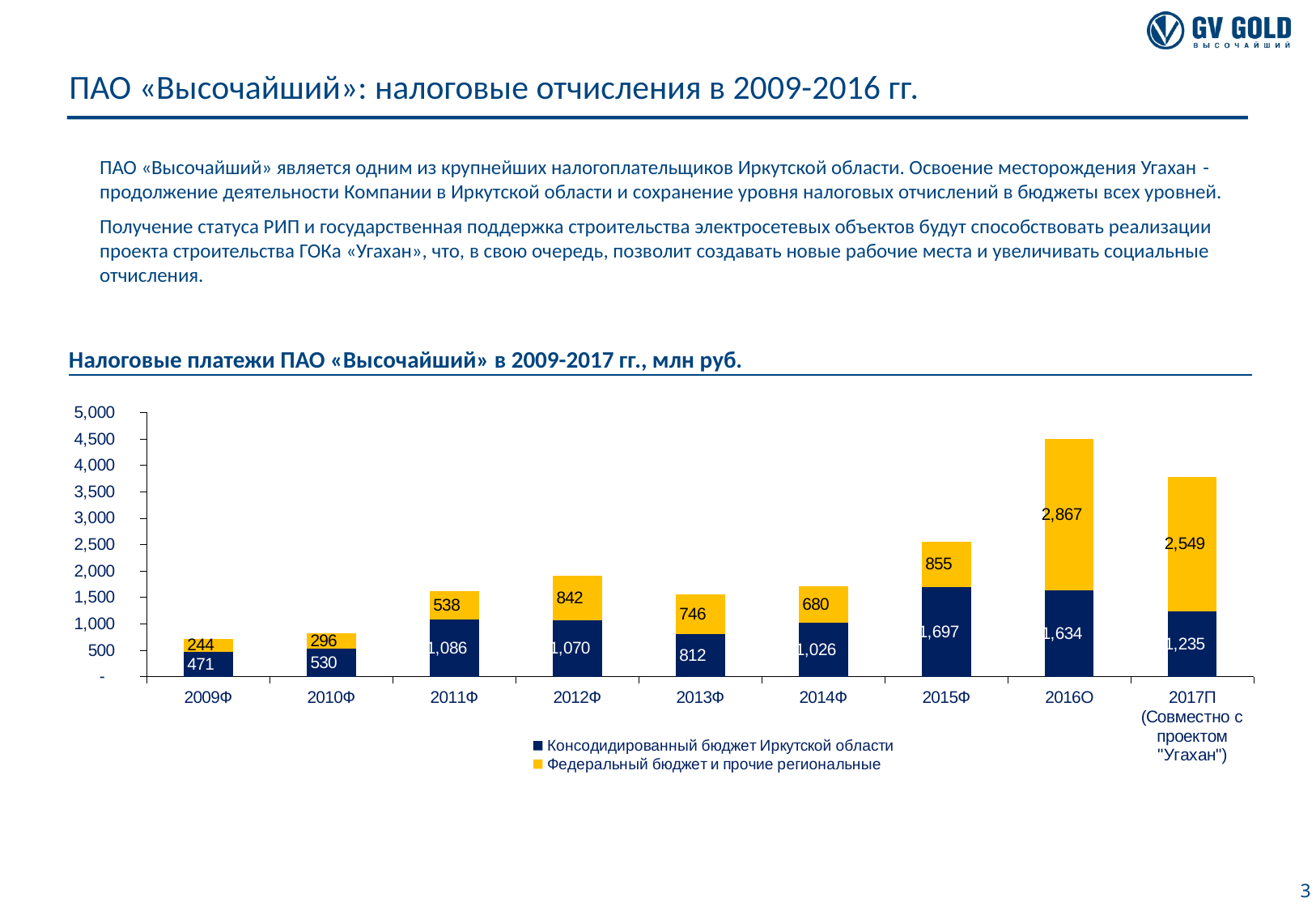
What is the value of Консодированный бюджет Иркутской области for 2015Ф? 1,697 Which year has the highest value for Федеральный бюджет и прочие региональные? 2016О What is the value of Федеральный бюджет и прочие региональные for 2016О? 2,867 What is the value of Федеральный бюджет и прочие региональные for 2009Ф? 244 Is the total of the stacked bar for 2017П greater or less than 3,500? greater How many series does the legend list? 2 Which is larger: Федеральный бюджет и прочие региональные for 2012Ф or for 2013Ф? 2012Ф How many categories (years) are shown on the x axis? 9 What is the difference between the Консодированный бюджет Иркутской области values for 2015Ф and 2014Ф? 671 What is the total of the stacked bar for 2016О? 4,501 What type of chart is shown on the slide? stacked bar chart Which year has the lowest value for Консодированный бюджет Иркутской области? 2009Ф